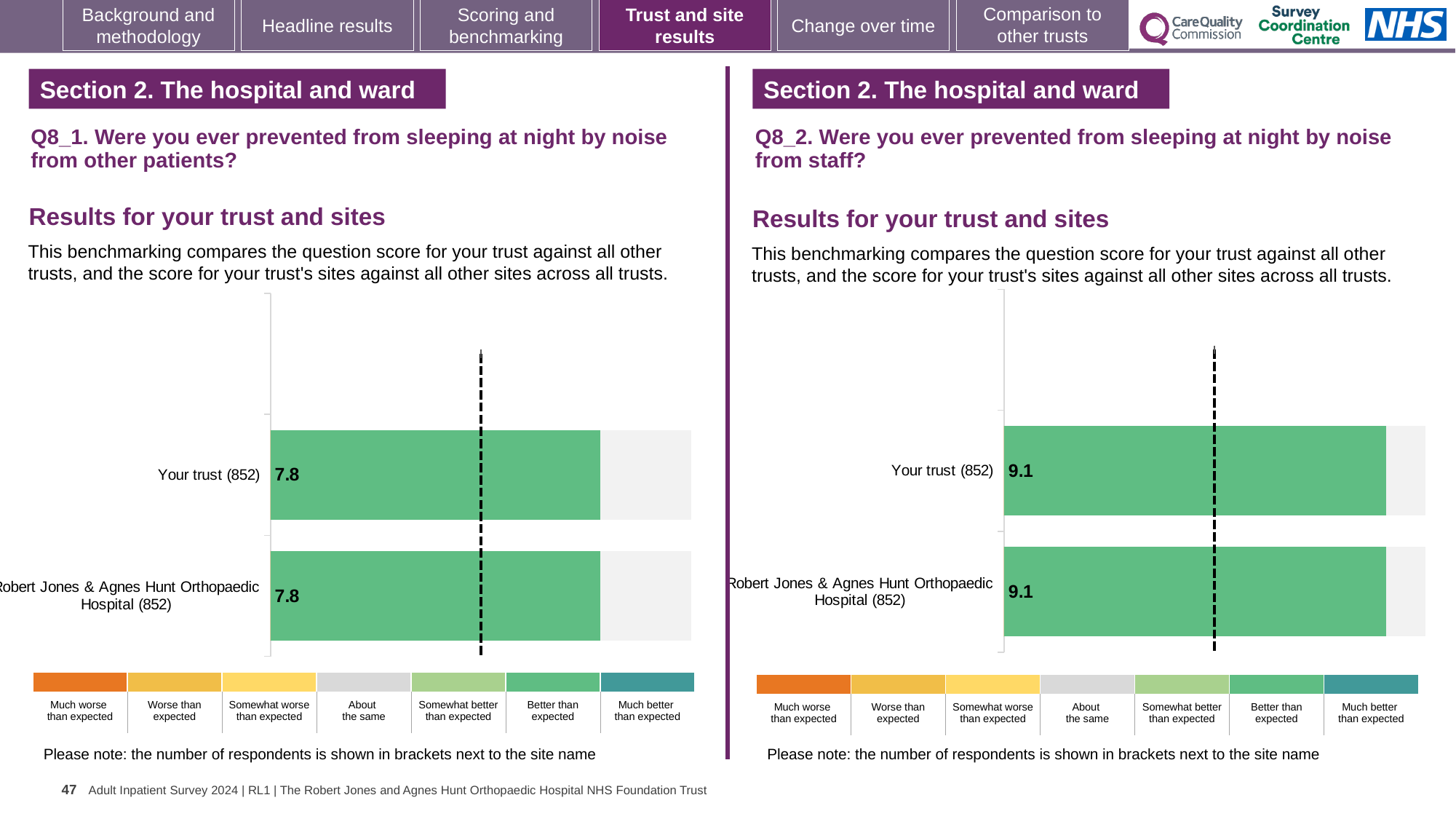
In the Q8_2 chart (right), what is the score for Your trust (852)? 9.1 In the Q8_1 chart (left), what is the difference between the score for Your trust and the score for Robert Jones & Agnes Hunt Orthopaedic Hospital? 0 In the Q8_1 chart (left), what is the score for Your trust (852)? 7.8 Is the score for Your trust in the Q8_1 chart (left) larger or smaller than the score for Your trust in the Q8_2 chart (right)? Smaller What kind of chart is the Q8_2 chart (right)? Bar chart In the Q8_2 chart (right), what is the score for Robert Jones & Agnes Hunt Orthopaedic Hospital (852)? 9.1 What colour are the bars in the Q8_2 chart (right)? Green How many bars are plotted in the Q8_2 chart (right)? 2 In the Q8_1 chart (left), how many respondents are shown in brackets next to Your trust? 852 In the Q8_1 chart (left), what is the score for Robert Jones & Agnes Hunt Orthopaedic Hospital (852)? 7.8 How many bars are plotted in the Q8_1 chart (left)? 2 In the Q8_2 chart (right), what is the difference between the score for Your trust and the score for Robert Jones & Agnes Hunt Orthopaedic Hospital? 0